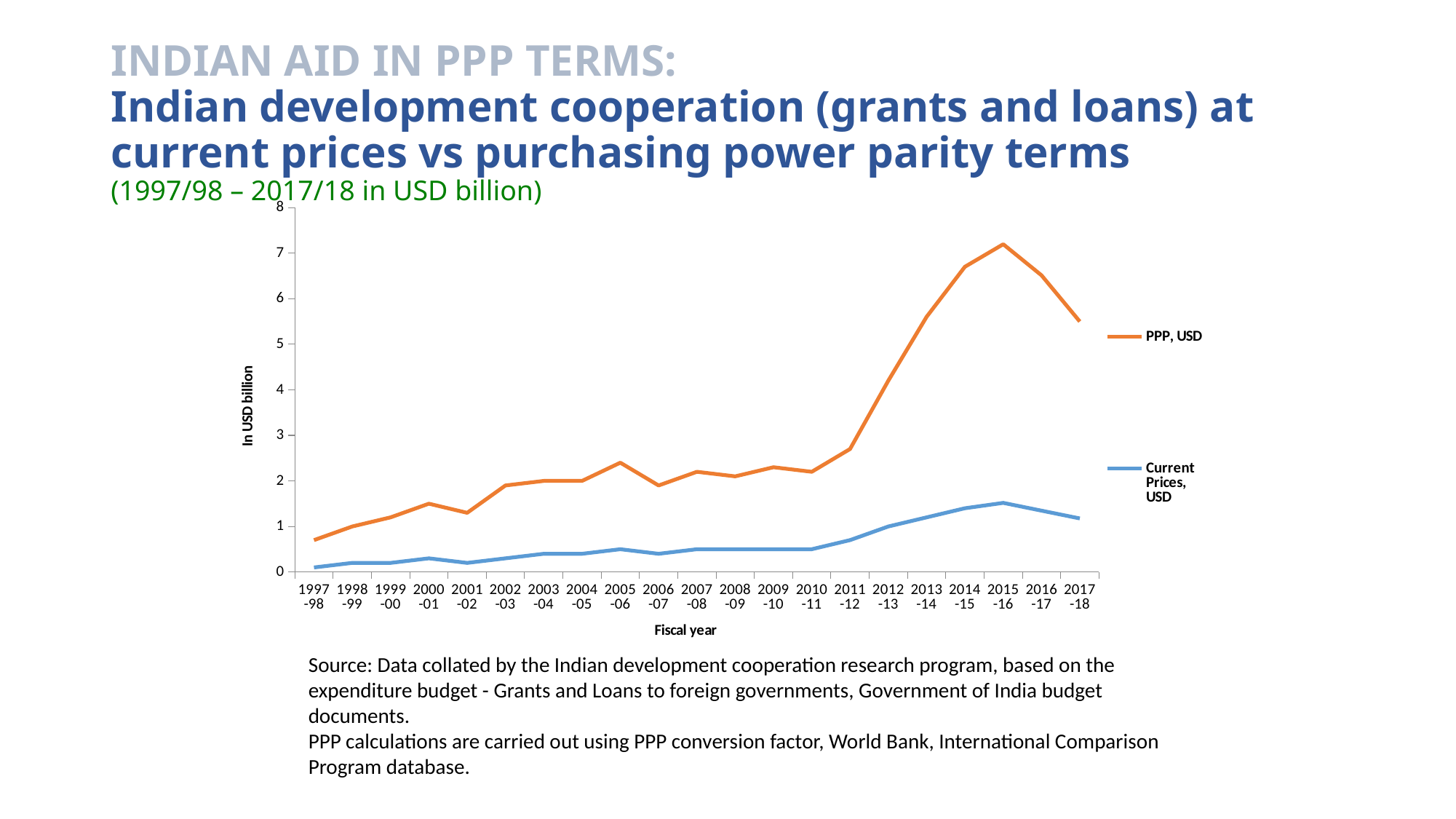
Is the PPP, USD value for 2017-18 greater or less than 5? greater Which series is higher in 2015-16, PPP, USD or Current Prices, USD? PPP, USD Is the PPP, USD value for 2015-16 greater or less than 6? greater Is the Current Prices, USD value for 1997-98 greater or less than 1? less In which fiscal year does the Current Prices, USD series reach its highest value? 2015-16 What kind of chart is shown on the slide? line chart In which fiscal year does the PPP, USD series reach its highest value? 2015-16 What is the label on the vertical axis of the chart? In USD billion Does the PPP, USD series rise or fall between 2015-16 and 2017-18? fall How many series does the legend list? 2 In which fiscal year is the PPP, USD series at its lowest? 1997-98 How many fiscal years are plotted along the x axis? 21